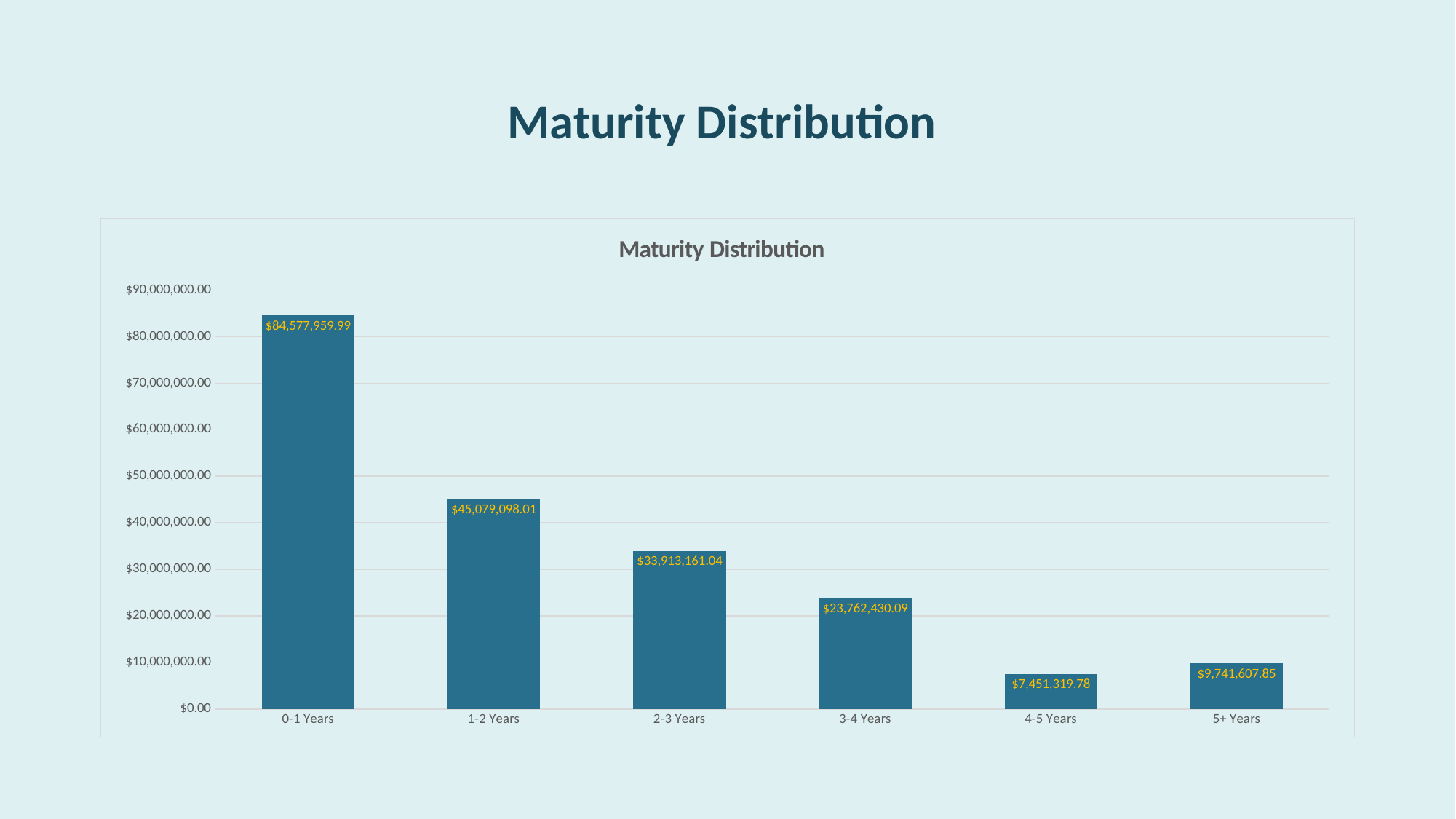
What is the value for 0-1 Years? $84,577,959.99 What is the difference between the values for 0-1 Years and 1-2 Years? $39,498,861.98 What is the difference between the values for 5+ Years and 4-5 Years? $2,290,288.07 What kind of chart is shown on the slide? bar chart What is the title of the chart? Maturity Distribution Which is larger, the value for 3-4 Years or the value for 5+ Years? 3-4 Years Which maturity bucket has the lowest value? 4-5 Years What is the value for 2-3 Years? $33,913,161.04 What is the value for 5+ Years? $9,741,607.85 Which maturity bucket has the highest value? 0-1 Years Is the value for 1-2 Years greater or less than $40,000,000.00? greater How many maturity buckets are shown on the x axis? 6